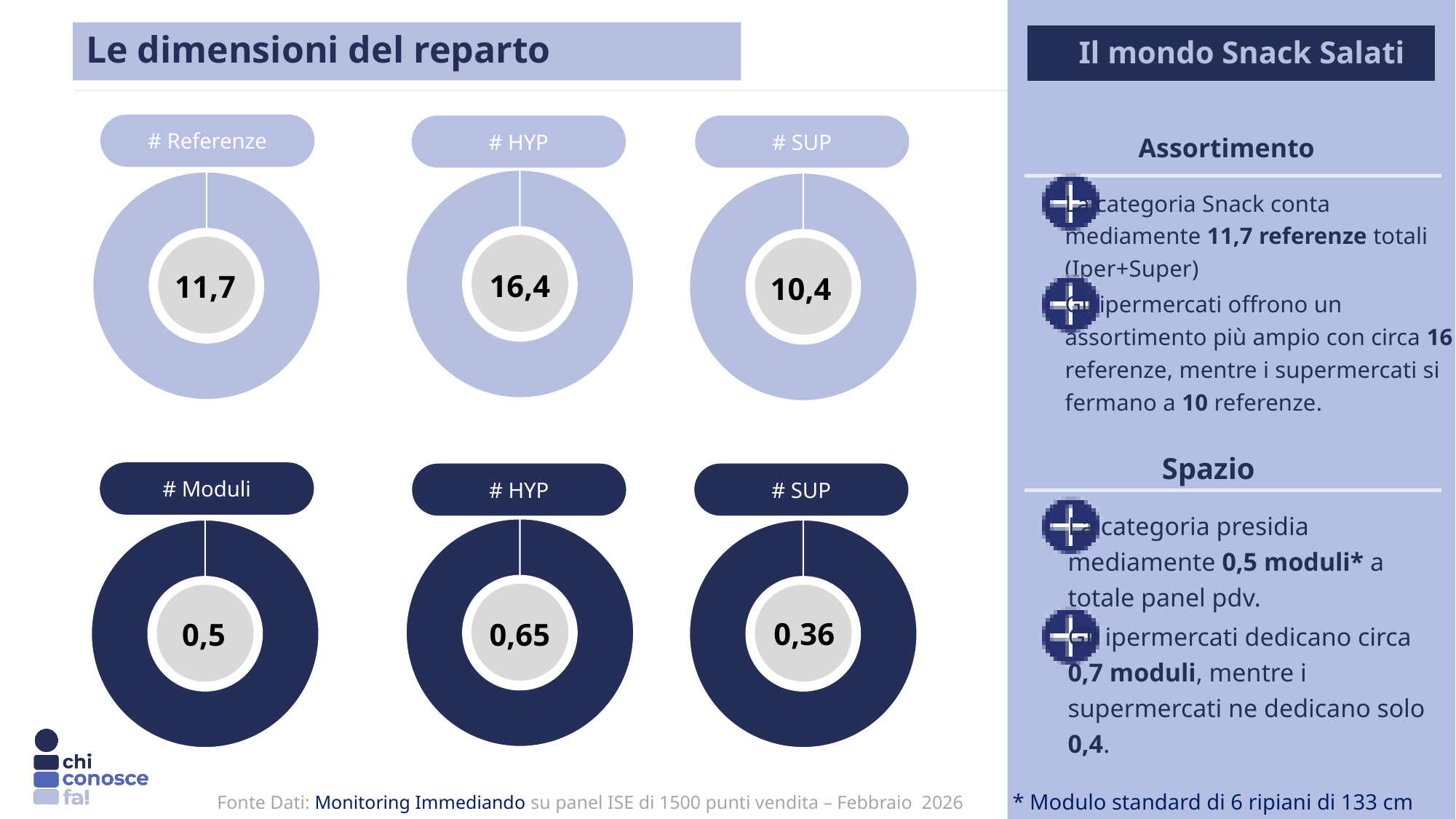
In the top row of circles, which label has the highest value? # HYP In the top row of circles, what is the difference between the # HYP value and the # SUP value? 6 In the bottom row of circles, what is the difference between the # HYP value and the # SUP value? 0,29 In the bottom row of circles, what value is shown for # Moduli? 0,5 In the bottom row of circles, which label has the lowest value? # SUP In the bottom row of circles, what value is shown for # HYP? 0,65 In the top row of circles, what value is shown for # HYP? 16,4 In the bottom row of circles, what value is shown for # SUP? 0,36 In the bottom row of circles, which is larger: the value for # HYP or the value for # SUP? # HYP How many circular value indicators are shown on the slide in total? 6 In the top row of circles, what value is shown for # SUP? 10,4 In the top row of circles, what value is shown for # Referenze? 11,7